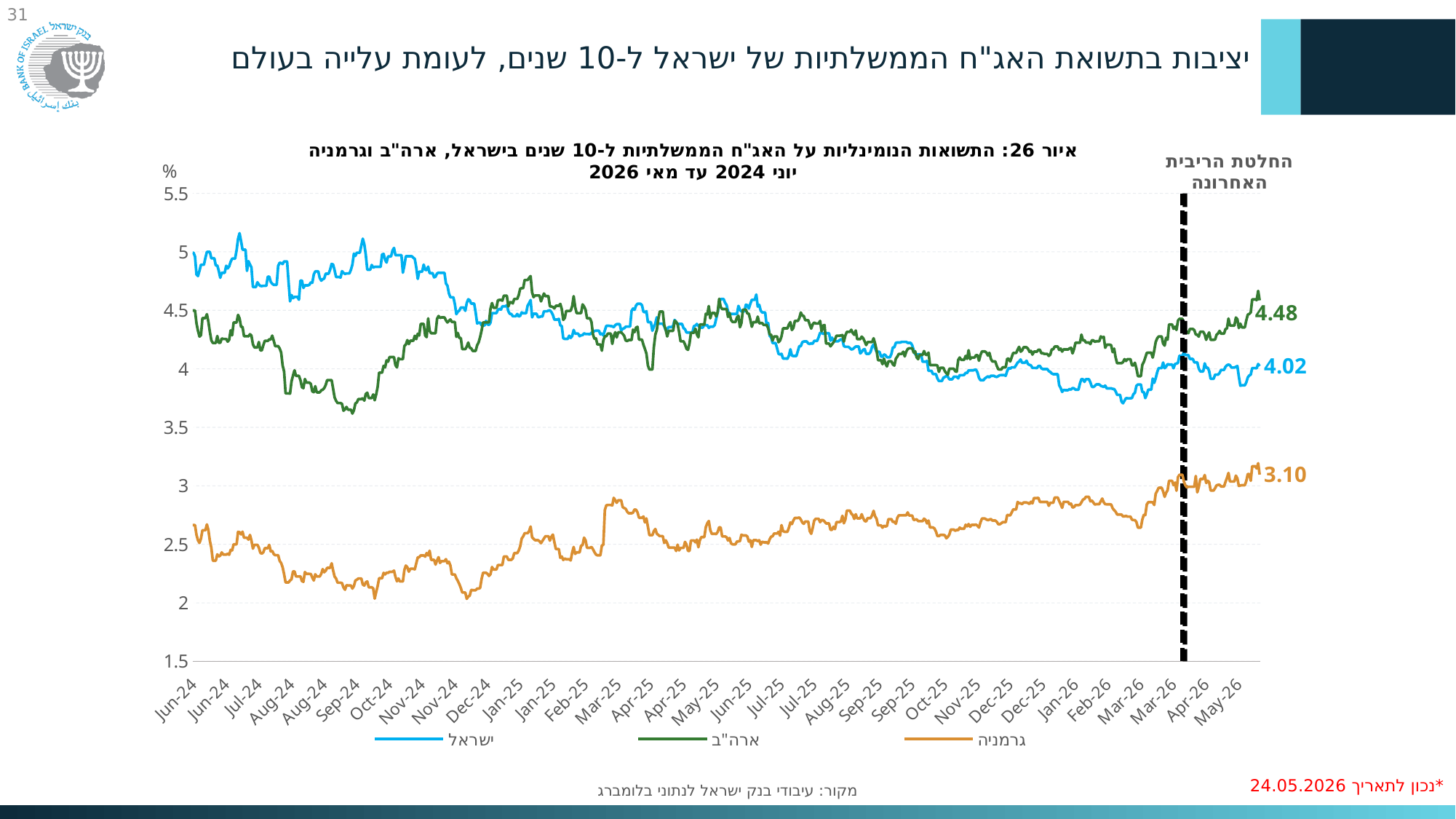
How many series does the legend list? 3 Is the value for ישראל at Jun-24 greater or less than 4.5? greater What is the difference between the latest labelled values for ארה"ב and ישראל? 0.46 Which series has the lowest value at the end of the chart (May-26)? גרמניה What is the latest labelled value for גרמניה (Germany)? 3.10 What kind of chart is shown on the slide? line chart What does the vertical dashed black line on the chart mark? החלטת הריבית האחרונה What is the latest labelled value for ישראל (Israel)? 4.02 What is the latest labelled value for ארה"ב (USA)? 4.48 Does the גרמניה (Germany) line overall rise or fall from Jun-24 to May-26? rise What is the difference between the latest labelled values for ישראל and גרמניה? 0.92 Which series has the highest value at the end of the chart (May-26)? ארה"ב